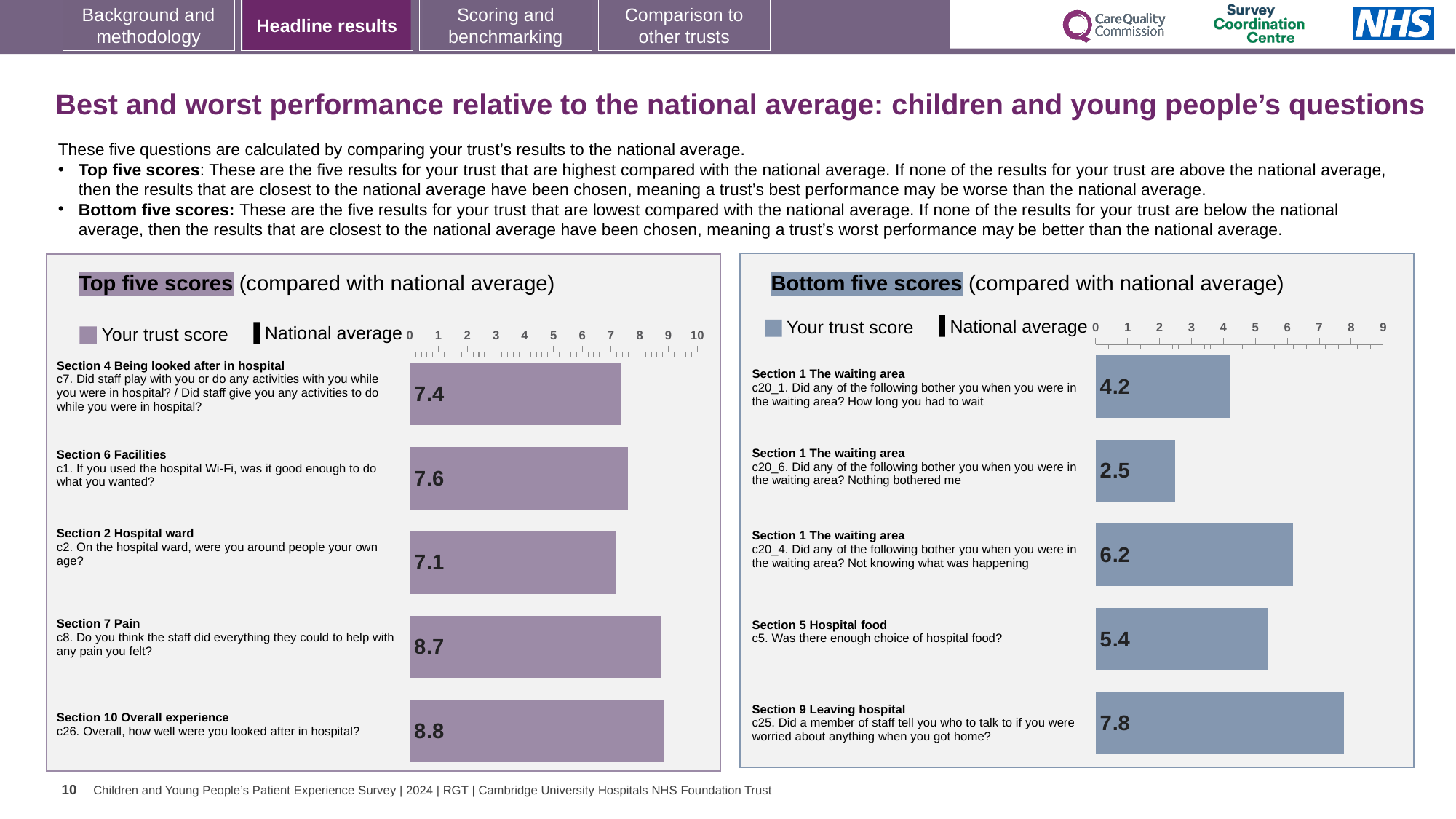
In the 'Top five scores' chart, what is the trust score for c8 (Section 7 Pain: Do you think the staff did everything they could to help with any pain you felt?)? 8.7 In the 'Bottom five scores' chart, is the trust score for c25 (Leaving hospital) greater or less than 7? greater What type of chart is used for the 'Bottom five scores'? Bar chart In the 'Top five scores' chart, what is the difference between the trust scores for c26 (Overall experience) and c2 (Hospital ward)? 1.7 In the 'Top five scores' chart, which question has the highest trust score? c26. Overall, how well were you looked after in hospital? (8.8) In the 'Bottom five scores' chart, which has the larger trust score: c20_4 (Not knowing what was happening) or c5 (enough choice of hospital food)? c20_4 (6.2) In the 'Top five scores' chart, what is the trust score for c1 (Section 6 Facilities: hospital Wi-Fi)? 7.6 In the 'Top five scores' chart, which question has the lowest trust score? c2. On the hospital ward, were you around people your own age? (7.1) In the 'Bottom five scores' chart, which question has the lowest trust score? c20_6. Nothing bothered me (2.5) How many bars are plotted in the 'Top five scores' chart? 5 In the 'Bottom five scores' chart, what is the trust score for c20_6 (Nothing bothered me in the waiting area)? 2.5 In the 'Bottom five scores' chart, what is the difference between the trust scores for c25 (Leaving hospital) and c20_1 (How long you had to wait)? 3.6